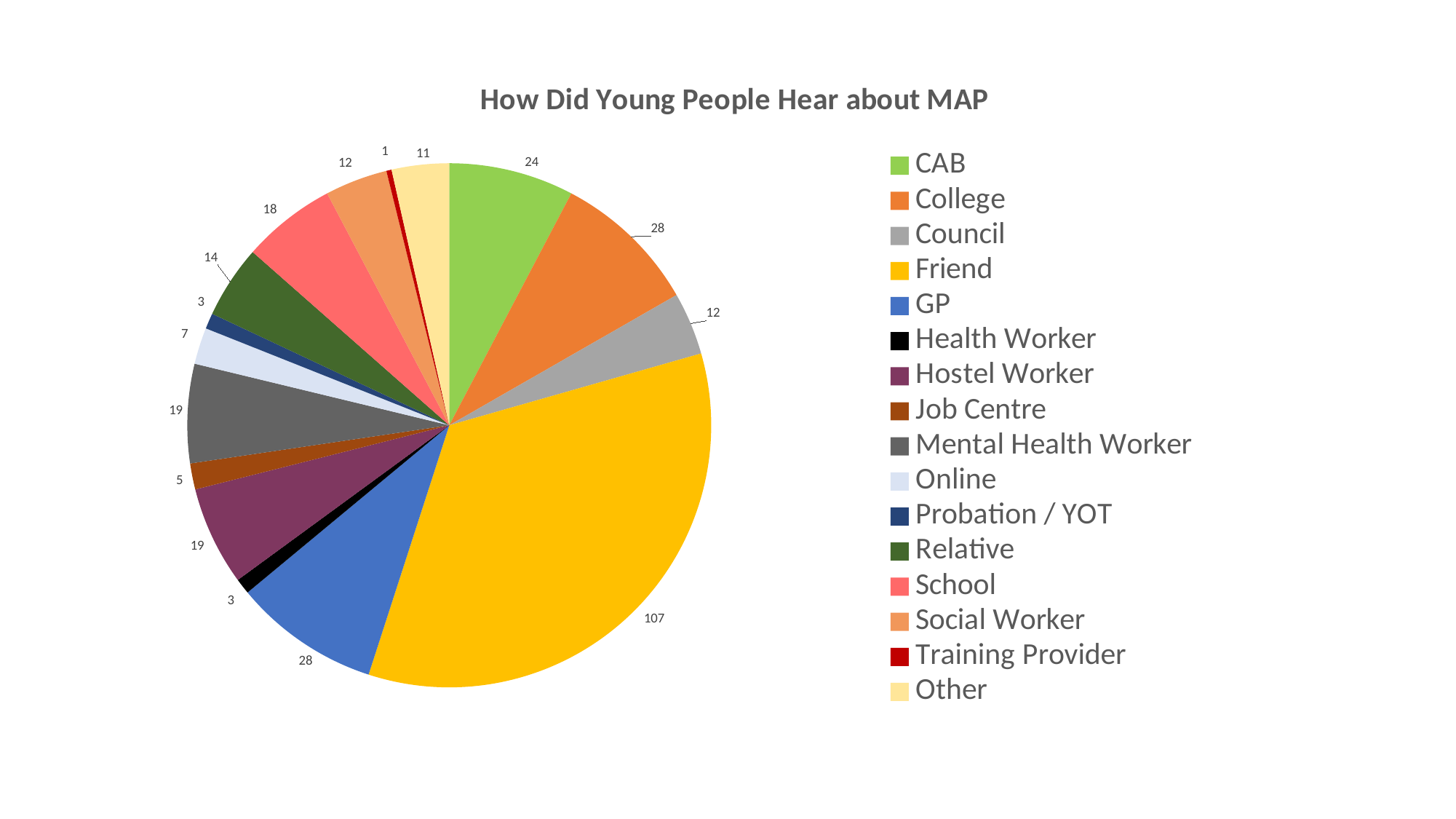
What is the value for Mental Health Worker? 19 What is the total of all the slices in the pie? 311 What is the value for CAB? 24 What is the difference between the values for Friend and GP? 79 Which category has the smallest slice? Training Provider What is the value for Friend? 107 Which is larger, the value for School or the value for Relative? School How many categories does the legend list? 16 Which category has the largest slice? Friend What is the title of the chart? How Did Young People Hear about MAP What is the value for Training Provider? 1 What type of chart is shown on the slide? pie chart